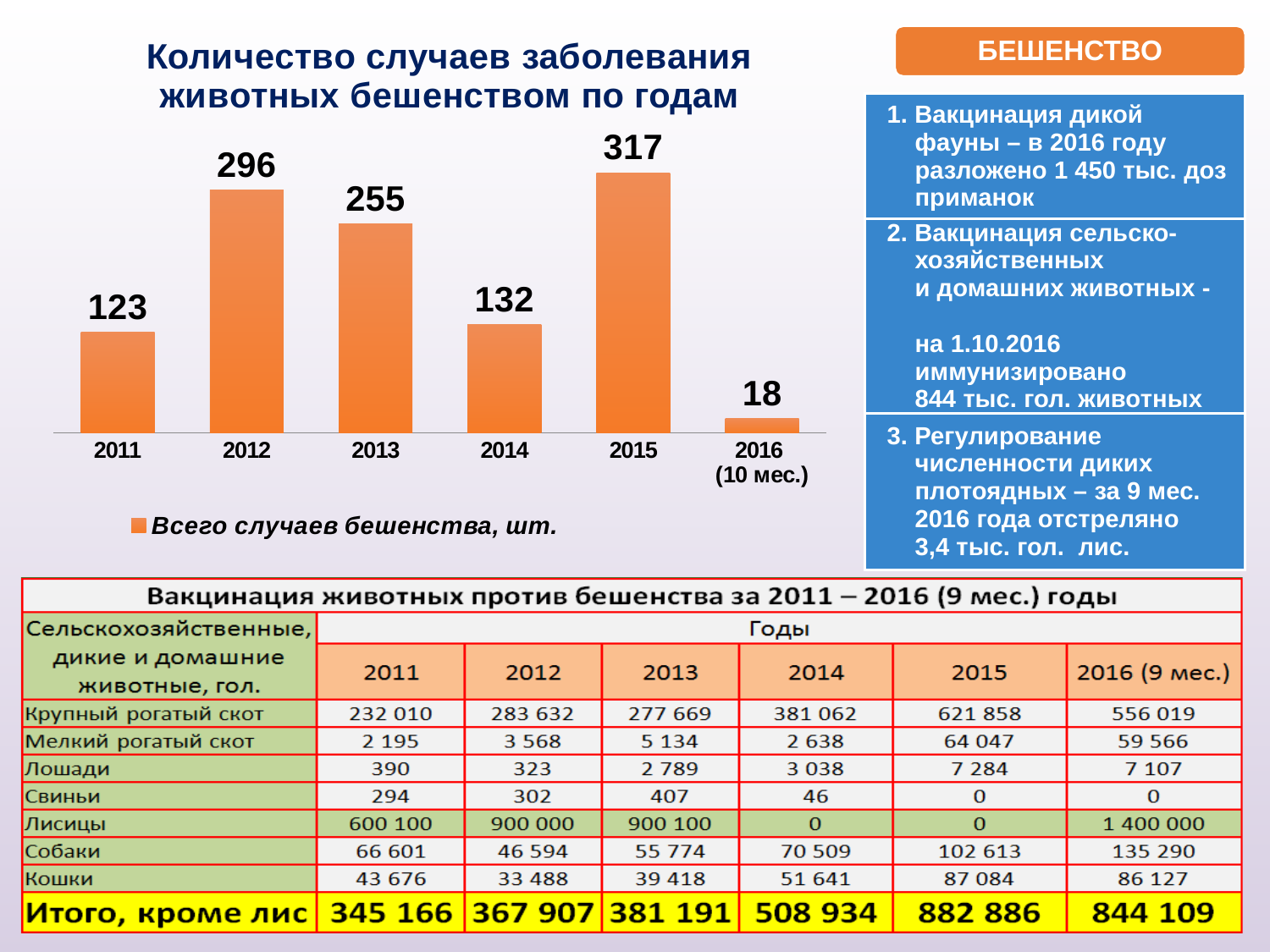
What is the difference between the values for 2015 and 2013? 62 Which year has the lowest value in the chart? 2016 (10 мес.) What is the difference between the values for 2012 and 2011? 173 What kind of chart is shown on the slide? bar chart How many years are shown on the x axis of the chart? 6 Which year has the highest value in the chart? 2015 What is the value for 2014 in the chart? 132 What is the legend entry of the chart? Всего случаев бешенства, шт. What is the value for 2016 (10 мес.) in the chart? 18 How many series does the chart legend list? 1 What is the value for 2012 in the chart? 296 Which is larger, the value for 2013 or the value for 2014? 2013